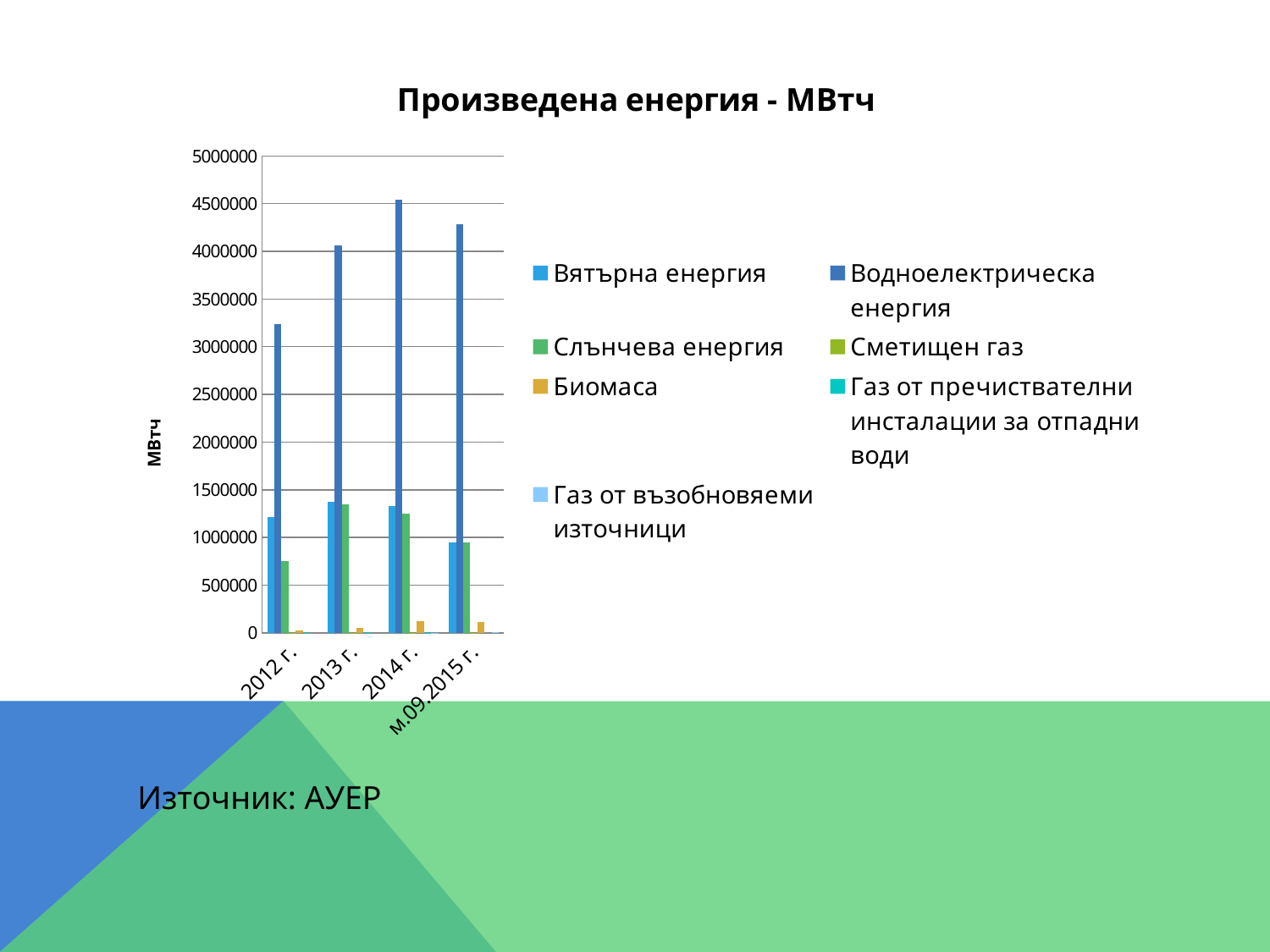
What is the title of the chart? Произведена енергия - МВтч What label is shown on the vertical axis? МВтч Is the value for Водноелектрическа енергия in 2014 г. greater or less than 4000000? greater Is the value for Водноелектрическа енергия in 2012 г. greater or less than 3500000? less Is the value for Вятърна енергия in 2012 г. greater or less than 1000000? greater How many series does the legend list? 7 Which is larger in 2012 г.: Вятърна енергия or Слънчева енергия? Вятърна енергия What kind of chart is shown on the slide? bar chart In which category is the value for Водноелектрическа енергия lowest? 2012 г. In which year is the value for Водноелектрическа енергия highest? 2014 г. How many categories are shown on the x axis? 4